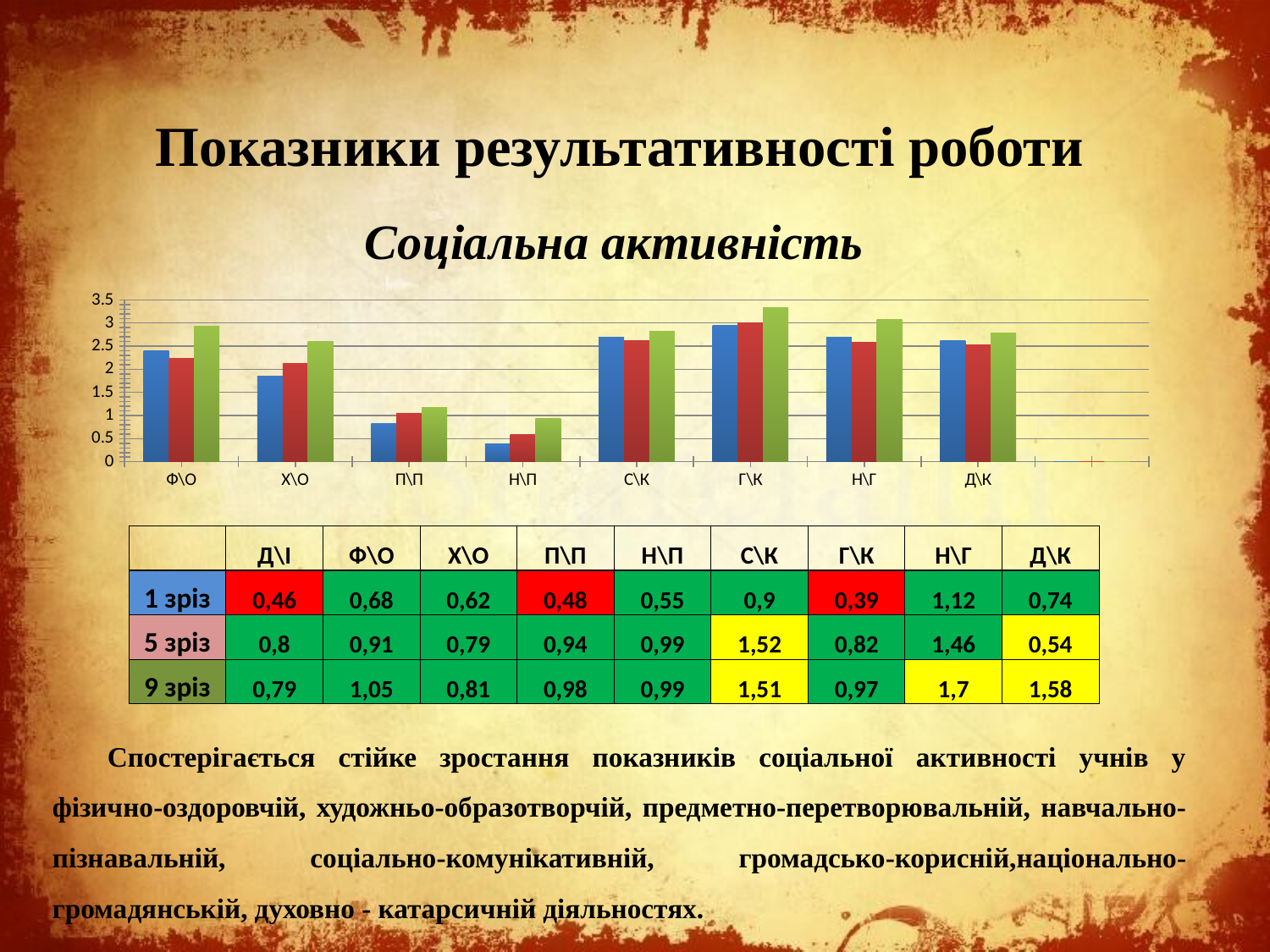
Which has the taller green bar, Ф\О or П\П? Ф\О Is the green bar for Г\К greater or less than 3? greater Is the blue bar for Н\П greater or less than 0.5? less How many bars are plotted for each category in the chart? 3 What is the highest value shown on the vertical axis of the chart? 3.5 Which category has the tallest green bar in the chart? Г\К Is the blue bar for Ф\О greater or less than 2? greater Which category has the shortest blue bar in the chart? Н\П What kind of chart is shown on the slide? bar chart How many categories are shown on the x axis of the chart? 8 Which has the taller blue bar, Х\О or Ф\О? Ф\О